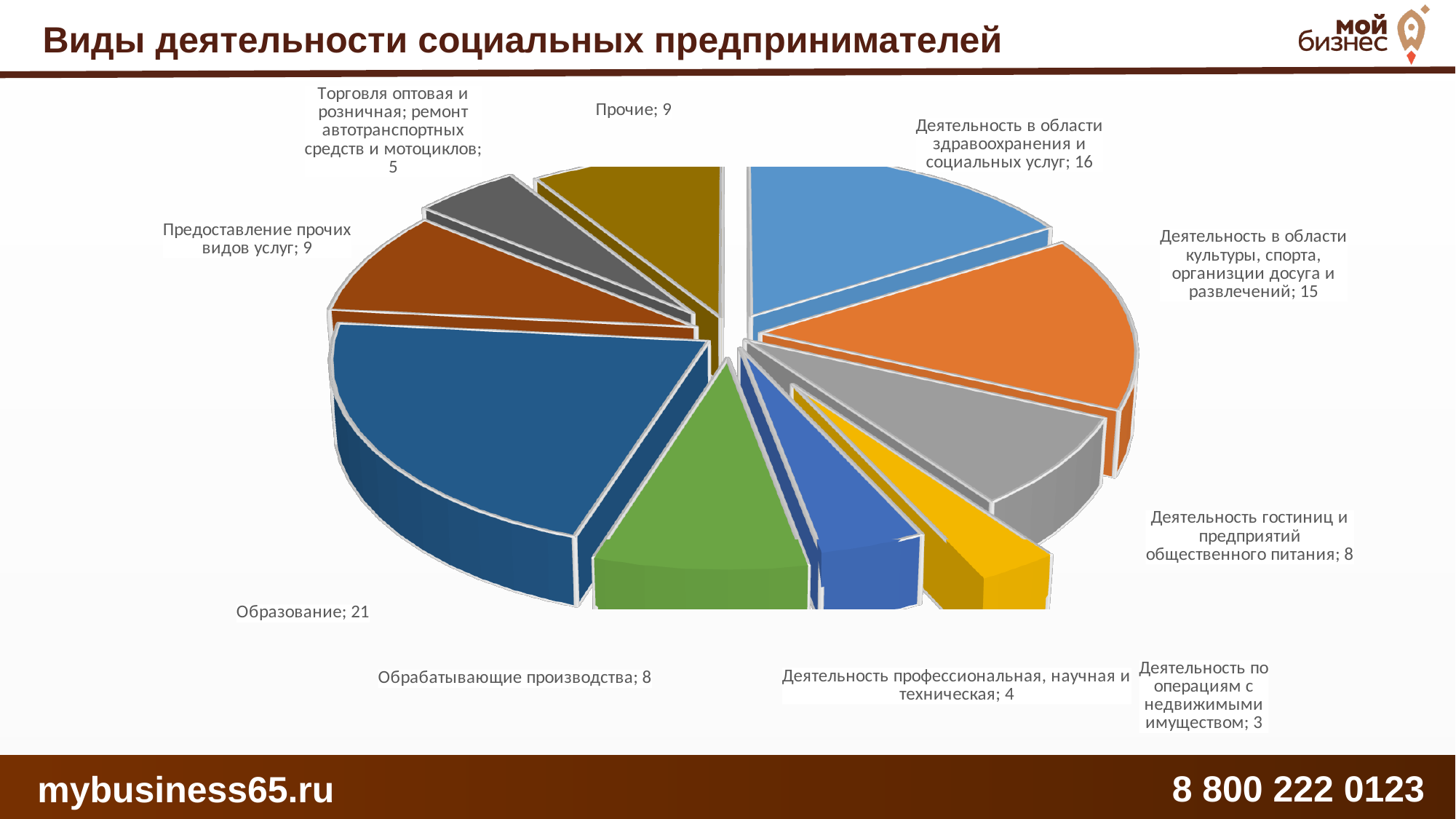
Which category has the smallest value? Деятельность по операциям с недвижимыми имуществом What is the value for Торговля оптовая и розничная; ремонт автотранспортных средств и мотоциклов? 5 What is the title of the slide? Виды деятельности социальных предпринимателей Which category has the largest value? Образование What is the value for Образование? 21 What is the value for Деятельность в области здравоохранения и социальных услуг? 16 Which is larger: Деятельность в области здравоохранения и социальных услуг or Деятельность в области культуры, спорта, организции досуга и развлечений? Деятельность в области здравоохранения и социальных услуг What is the value for Прочие? 9 What is the difference between the values for Деятельность гостиниц и предприятий общественного питания and Деятельность по операциям с недвижимыми имуществом? 5 How many categories (slices) does the pie chart have? 10 What kind of chart is shown on the slide? Pie chart What is the difference between the values for Образование and Деятельность в области здравоохранения и социальных услуг? 5